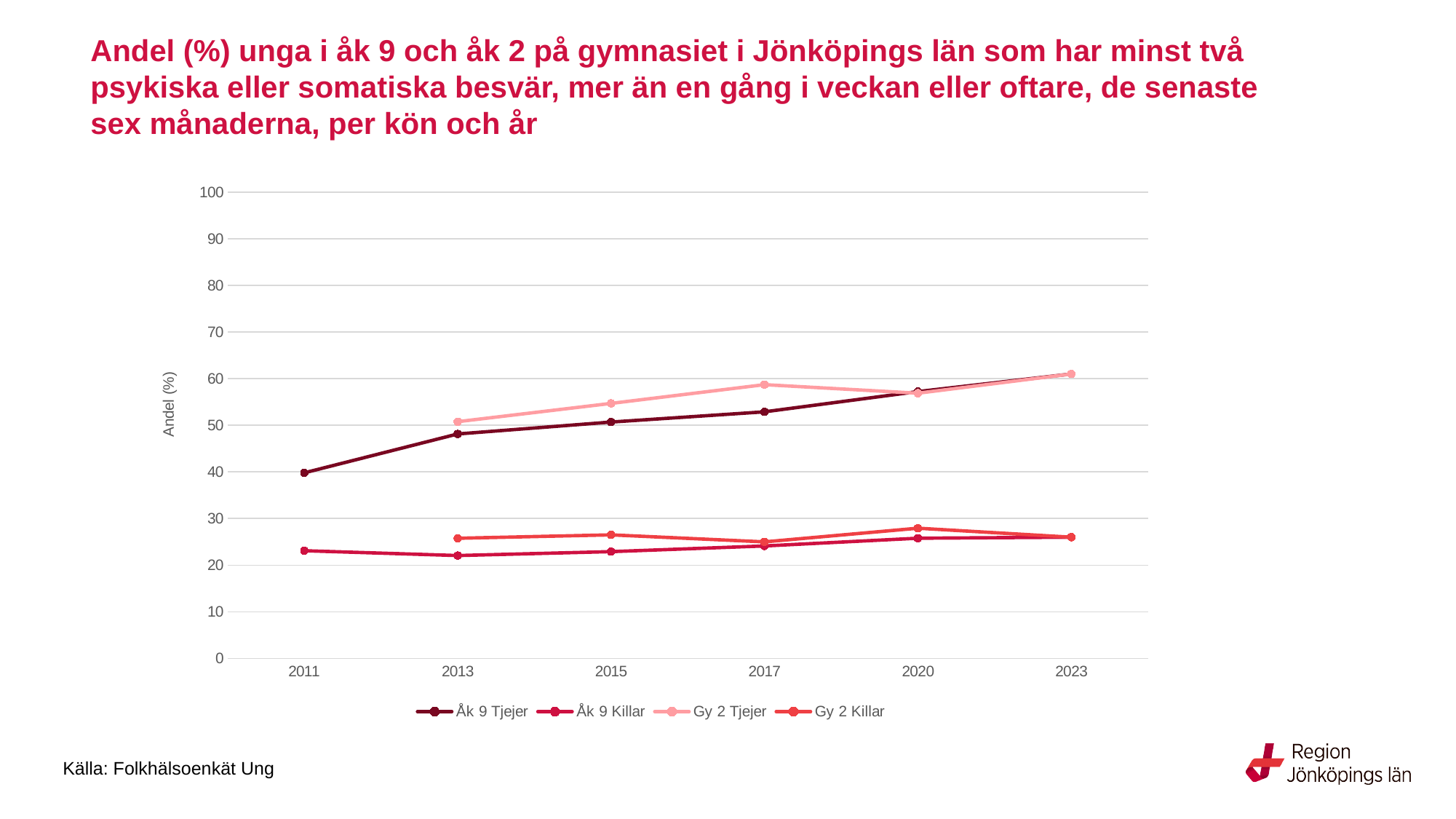
Is the value for Åk 9 Killar in 2013 greater or less than 30? less How many series does the legend list? 4 Is the value for Åk 9 Tjejer in 2017 greater or less than 50? greater What kind of chart is shown on the slide? Line chart Does the value for Åk 9 Tjejer rise or fall from 2011 to 2023? Rise Which series has the highest value in 2017? Gy 2 Tjejer What is the label on the y axis? Andel (%) In 2023, which is larger: the value for Åk 9 Tjejer or the value for Åk 9 Killar? Åk 9 Tjejer Which series has the lowest value in 2013? Åk 9 Killar Is the value for Åk 9 Tjejer in 2013 greater or less than 50? less How many years are shown on the x axis? 6